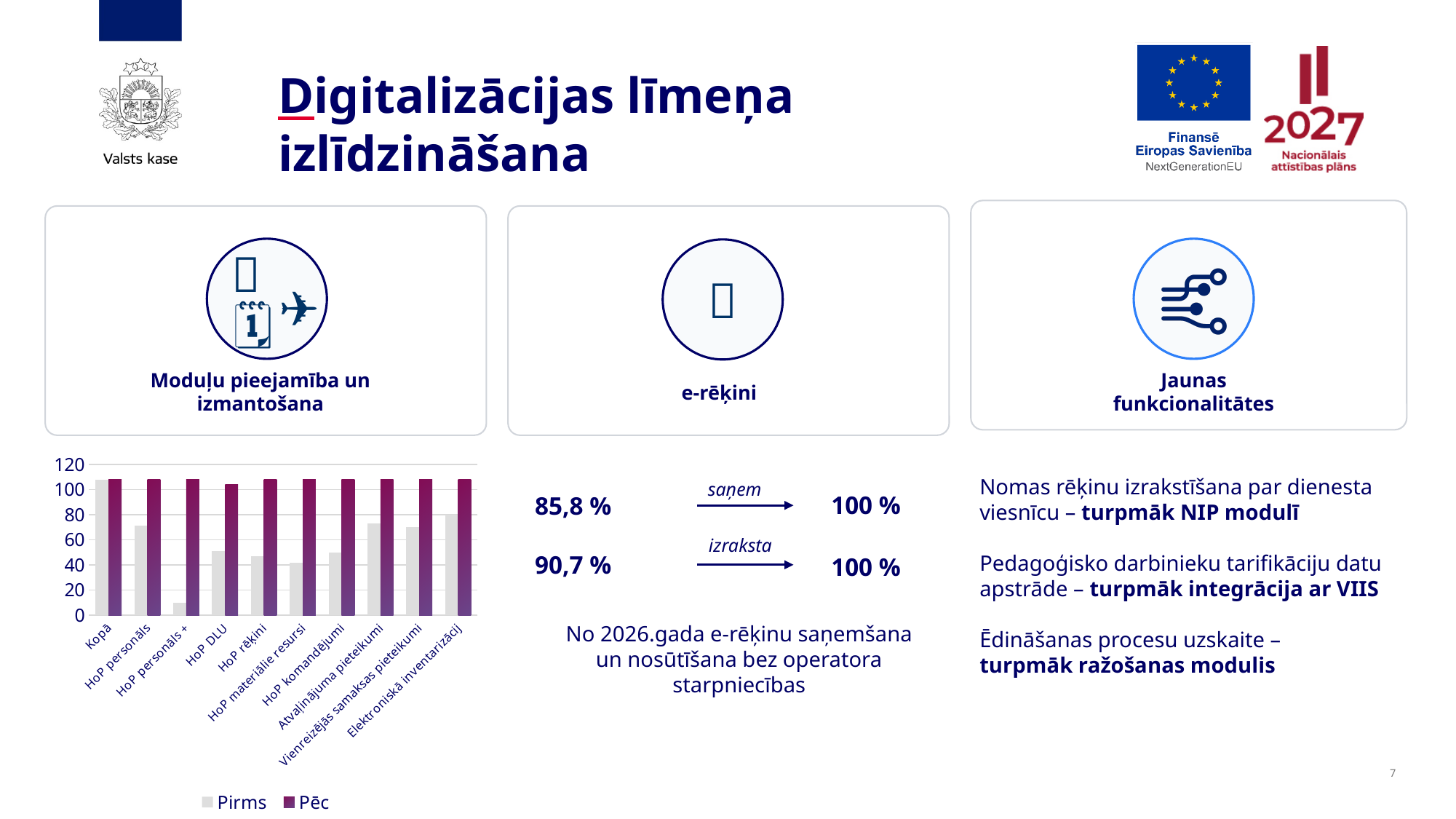
Which is larger, the Pirms value for HoP personāls or the Pirms value for HoP personāls +? HoP personāls For HoP rēķini, which series has the larger value, Pirms or Pēc? Pēc Which category has the highest Pirms value? Kopā Is the Pirms value for HoP materiālie resursi greater or less than 60? less Is the Pirms value for HoP personāls + greater or less than 20? less Which category has the lowest Pirms value? HoP personāls + How many series does the chart legend list? 2 Is the Pēc value for Kopā greater or less than 100? greater How many categories are shown on the x axis of the chart? 10 What kind of chart is shown on the slide? bar chart What are the two series named in the chart legend? Pirms and Pēc